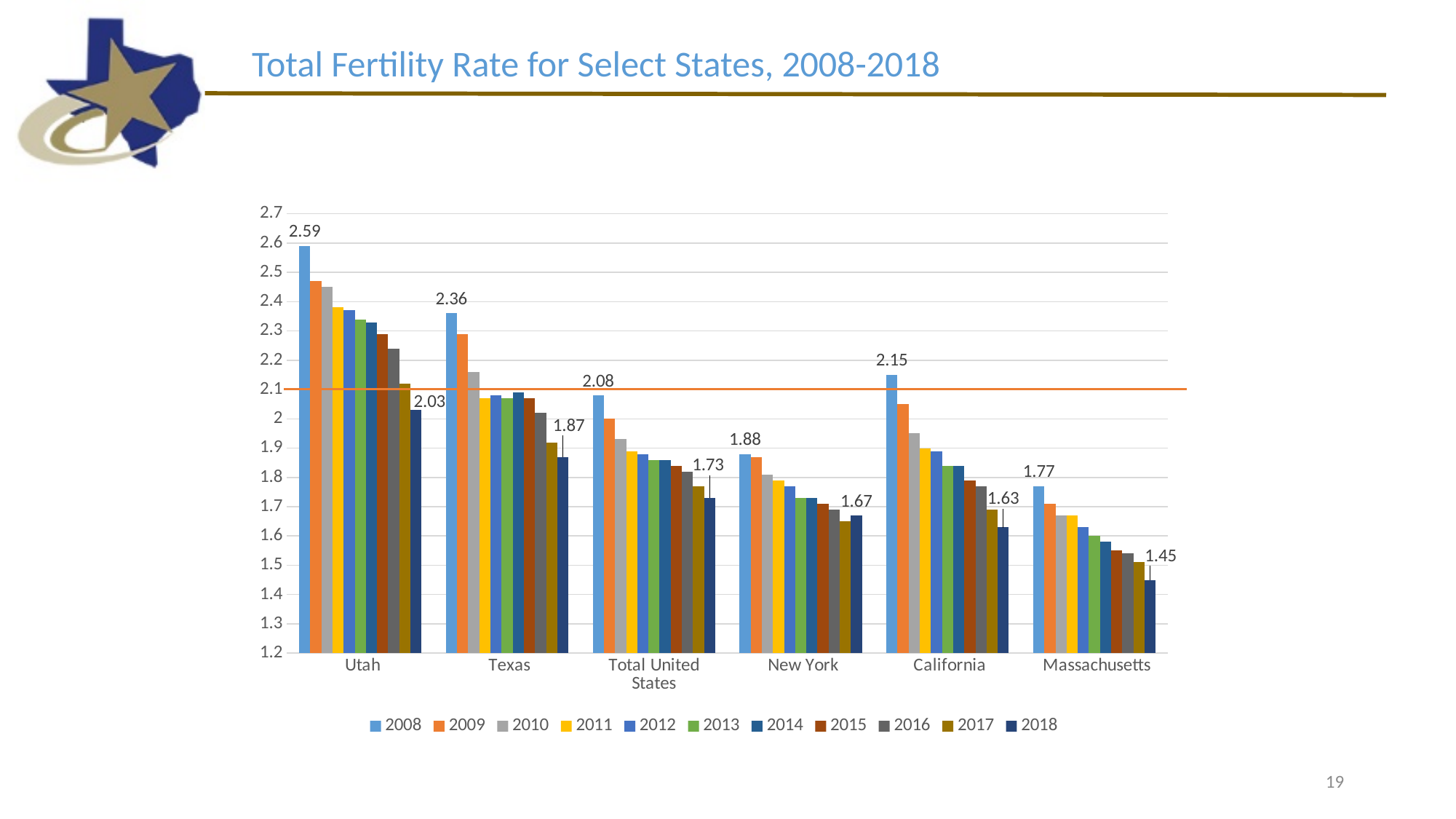
What was the total fertility rate for Texas in 2018? 1.87 What was the total fertility rate for Utah in 2008? 2.59 What was the total fertility rate for Massachusetts in 2018? 1.45 What kind of chart is shown on the slide? Bar chart Which category had the lowest total fertility rate in 2018? Massachusetts Is the 2012 value for Utah greater or less than 2.1? greater Which was higher in 2018: the total fertility rate for New York or for California? New York By how much did Texas's total fertility rate fall from 2008 to 2018? 0.49 Which state had the highest total fertility rate in 2008? Utah How many series does the legend list? 11 What was the total fertility rate for California in 2008? 2.15 Within each state, do the bars rise or fall from 2008 to 2018? Fall